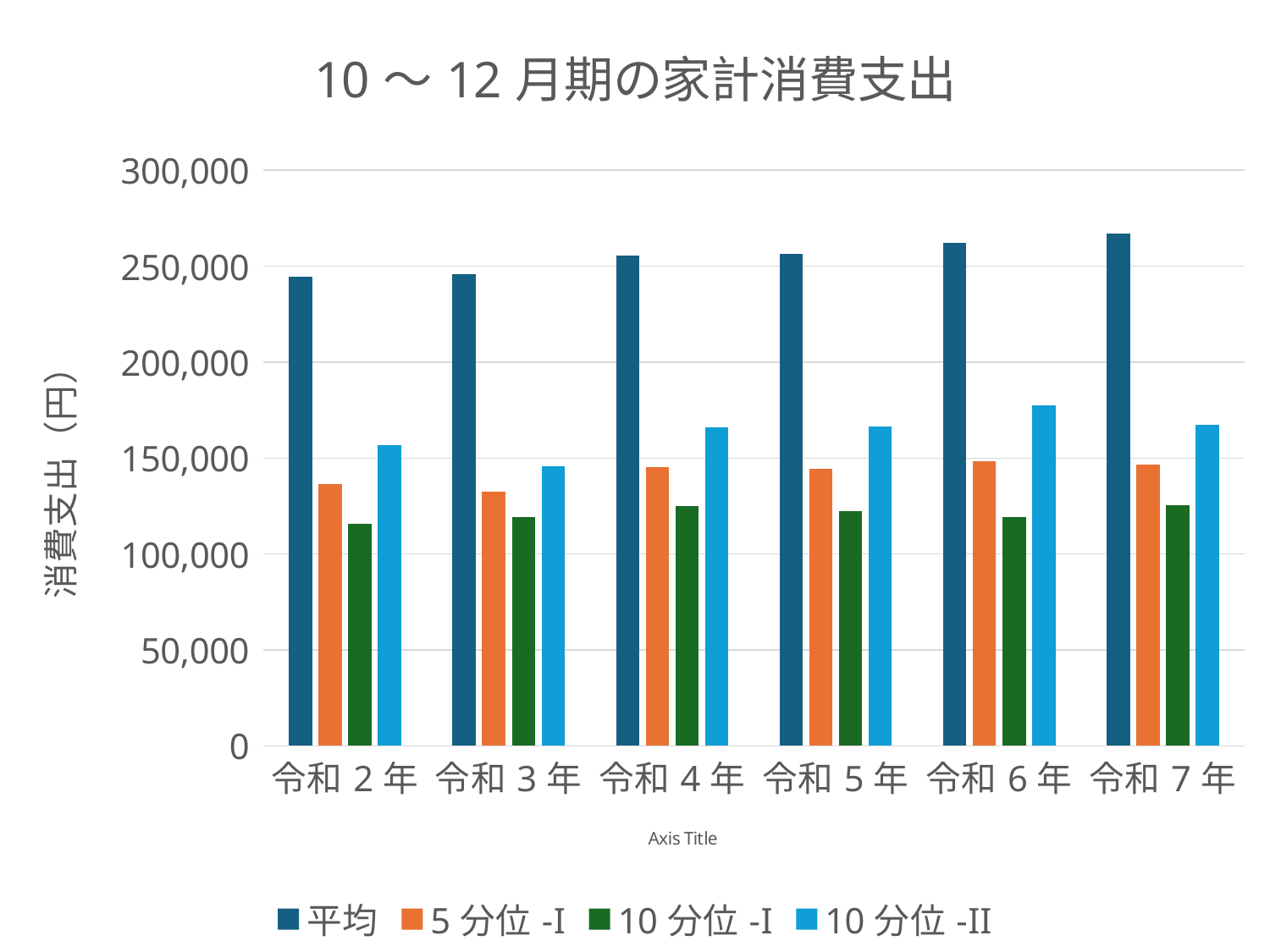
How many year categories are shown on the x axis? 6 Is the value for 平均 in 令和７年 greater or less than 250,000? greater Is the value for 10分位-II in 令和６年 greater or less than 150,000? greater Which year has the highest value for 平均? 令和７年 Is the value for 平均 in 令和２年 greater or less than 250,000? less What kind of chart is shown on the slide? Bar chart Which year has the lowest value for 10分位-II? 令和３年 How many series does the legend list? 4 Which year has the highest value for 10分位-II? 令和６年 What is the title of the chart? 10～12月期の家計消費支出 In 令和２年, which is larger: 5分位-I or 10分位-II? 10分位-II Does the value for 平均 generally rise or fall from 令和２年 to 令和７年? rise